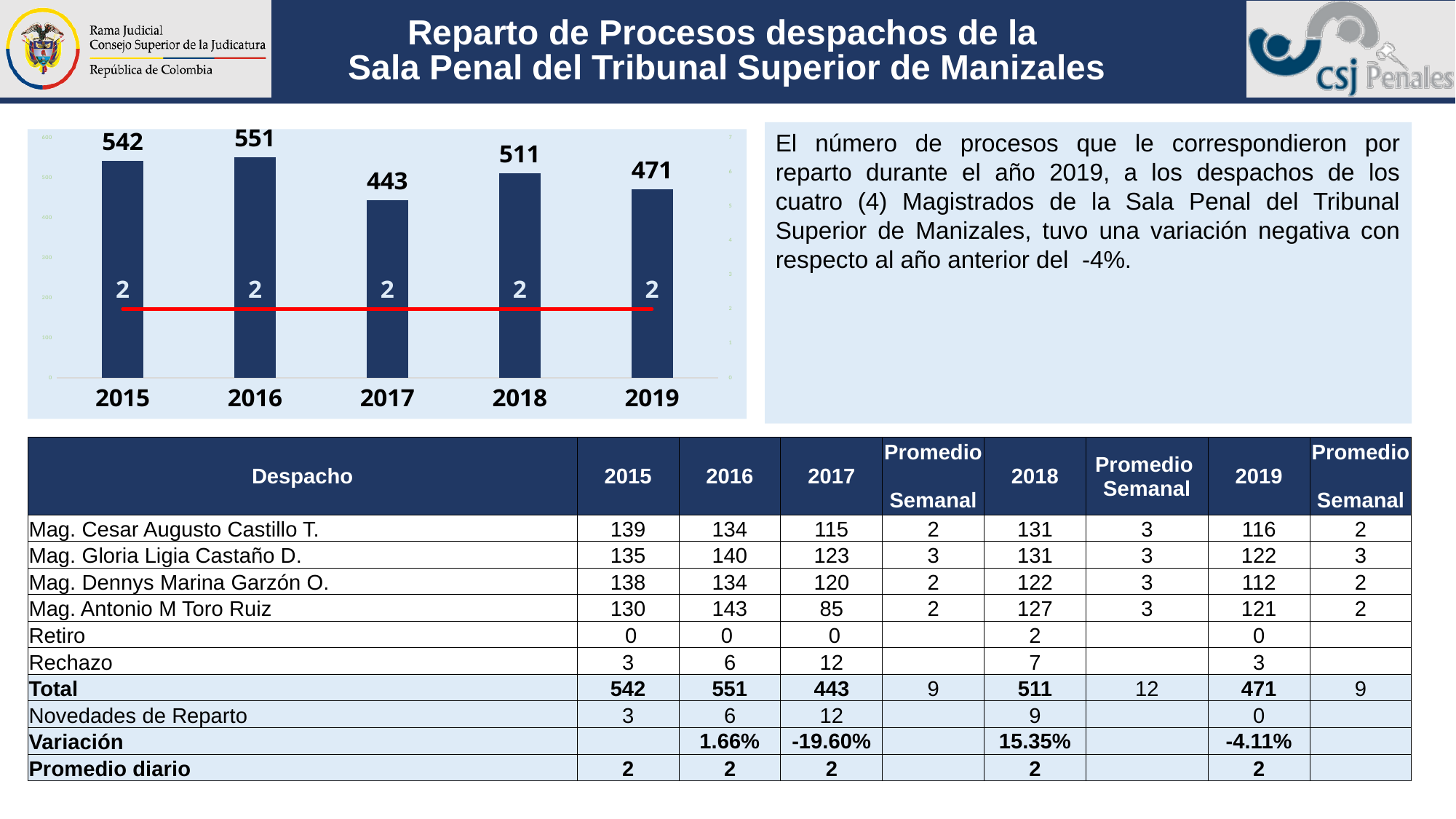
Which is larger, the bar for 2018 or the bar for 2019? 2018 What kind of chart is shown on the slide? Bar chart with a line What value does the red line show for each year? 2 What is the value of the bar for 2019? 471 Which year has the lowest bar? 2017 What is the difference between the bar values for 2015 and 2019? 71 What is the value of the bar for 2017? 443 What colour are the bars in the chart? Dark blue How many years are shown on the x axis of the chart? 5 Do the bar values rise or fall from 2018 to 2019? Fall What is the value of the bar for 2016? 551 Which year has the highest bar? 2016